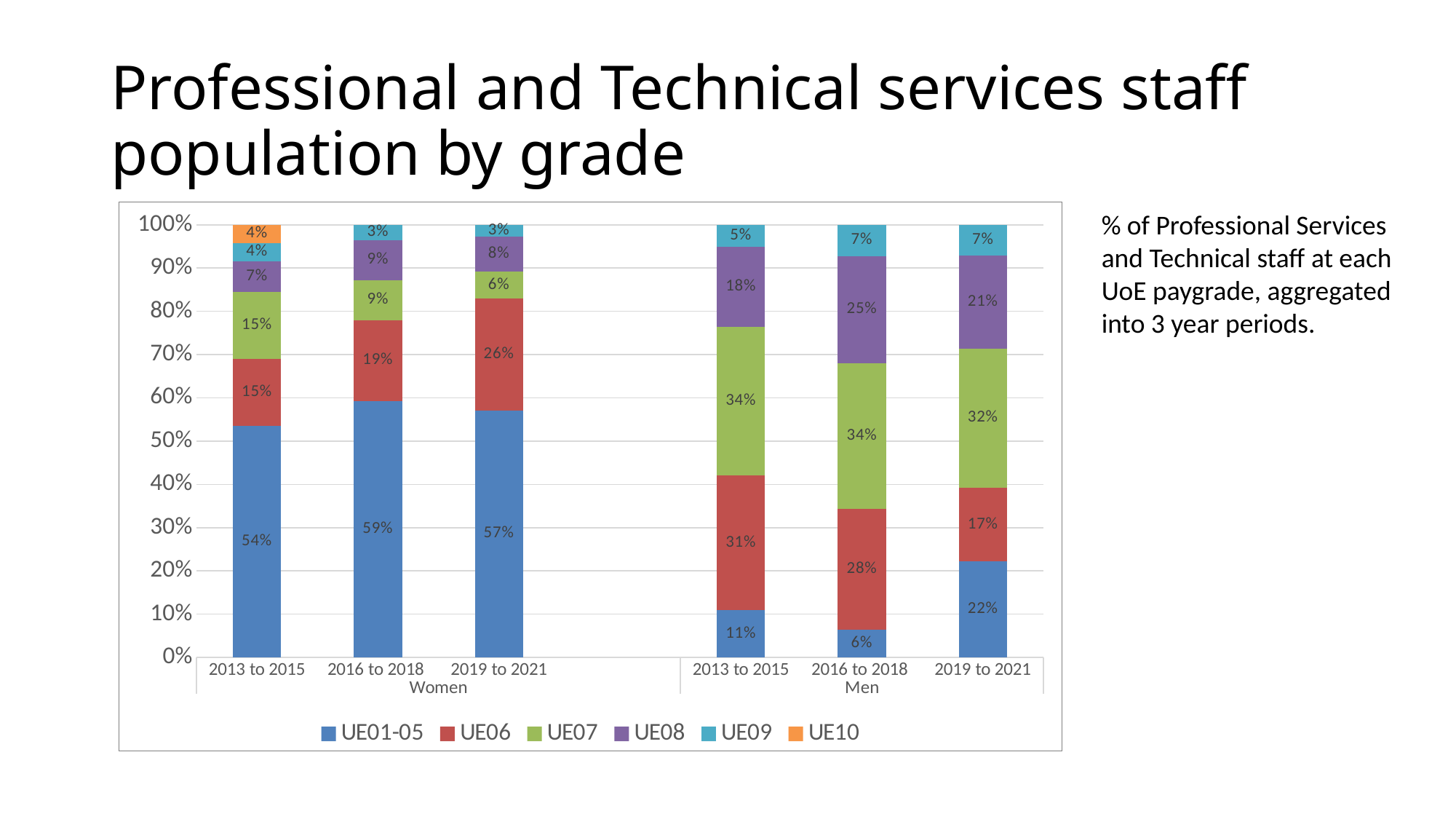
Which period has the highest UE01-05 value for Women? 2016 to 2018 What kind of chart is shown on the slide? Stacked bar chart Which series is shown in orange in the legend? UE10 How many series does the legend list? 6 What is the UE08 value for Men in 2016 to 2018? 25% Which is larger: the UE08 value for Women in 2013 to 2015 or the UE08 value for Men in 2013 to 2015? Men in 2013 to 2015 What is the UE01-05 value for Women in 2016 to 2018? 59% Which period has the lowest UE01-05 value for Men? 2016 to 2018 What is the difference between the UE06 value for Men in 2013 to 2015 and the UE06 value for Men in 2019 to 2021? 14% What is the UE06 value for Women in 2019 to 2021? 26% How many bars are plotted in the chart? 6 What is the UE07 value for Men in 2019 to 2021? 32%